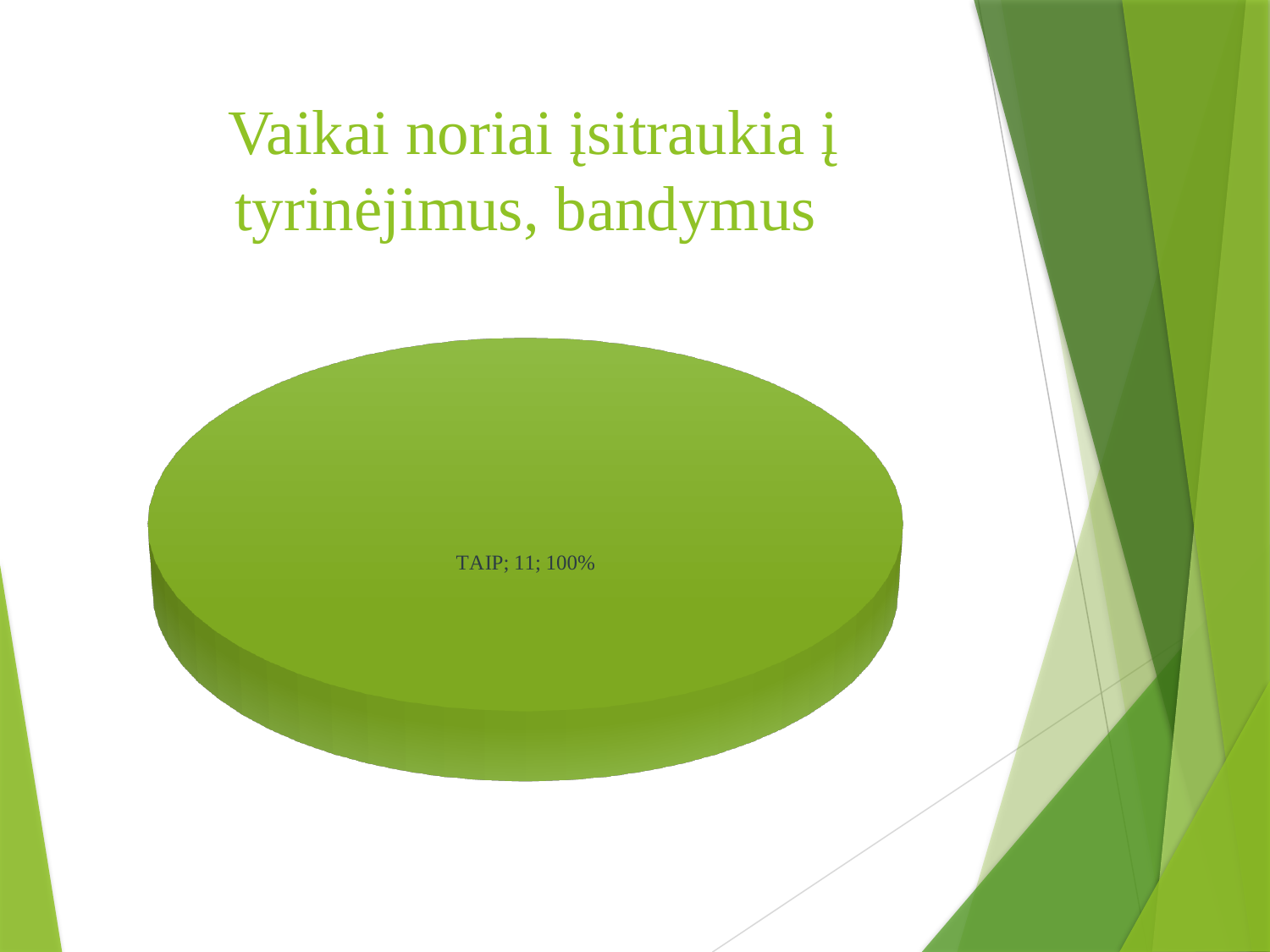
What is the value for TAIP? 11 How many slices does the pie chart have? 1 What kind of chart is shown on the slide? pie chart Is the value for TAIP greater or less than 10? greater What is the title of the slide containing the pie chart? Vaikai noriai įsitraukia į tyrinėjimus, bandymus What share of the pie does TAIP represent? 100% What is the label of the only slice in the pie chart? TAIP